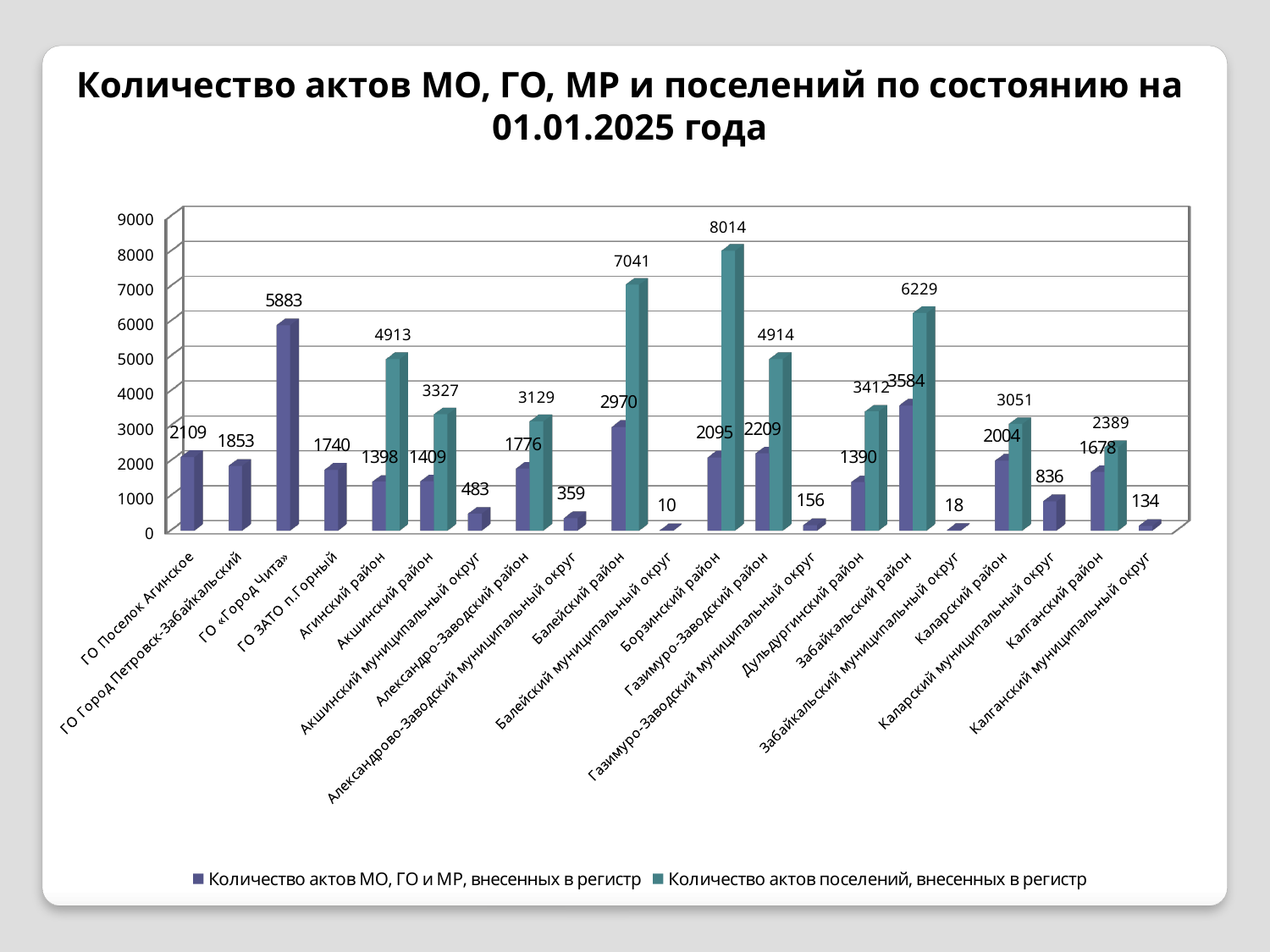
What is the value of 'Количество актов МО, ГО и МР, внесенных в регистр' for Забайкальский район? 3584 What is the title of the chart? Количество актов МО, ГО, МР и поселений по состоянию на 01.01.2025 года Is the value for 'Количество актов МО, ГО и МР' for Каларский муниципальный округ greater or less than 1000? less What is the value of 'Количество актов поселений, внесенных в регистр' for Борзинский район? 8014 What kind of chart is shown on the slide? Bar chart Which category has the highest value for 'Количество актов поселений, внесенных в регистр'? Борзинский район How many series does the legend list? 2 What is the value of 'Количество актов МО, ГО и МР, внесенных в регистр' for ГО «Город Чита»? 5883 Which is larger: the 'Количество актов поселений' value for Агинский район or for Газимуро-Заводский район? Газимуро-Заводский район How many categories are shown on the x axis? 21 Which category has the lowest value for 'Количество актов МО, ГО и МР, внесенных в регистр'? Балейский муниципальный округ What is the difference between the two series values for Балейский район (7041 and 2970)? 4071